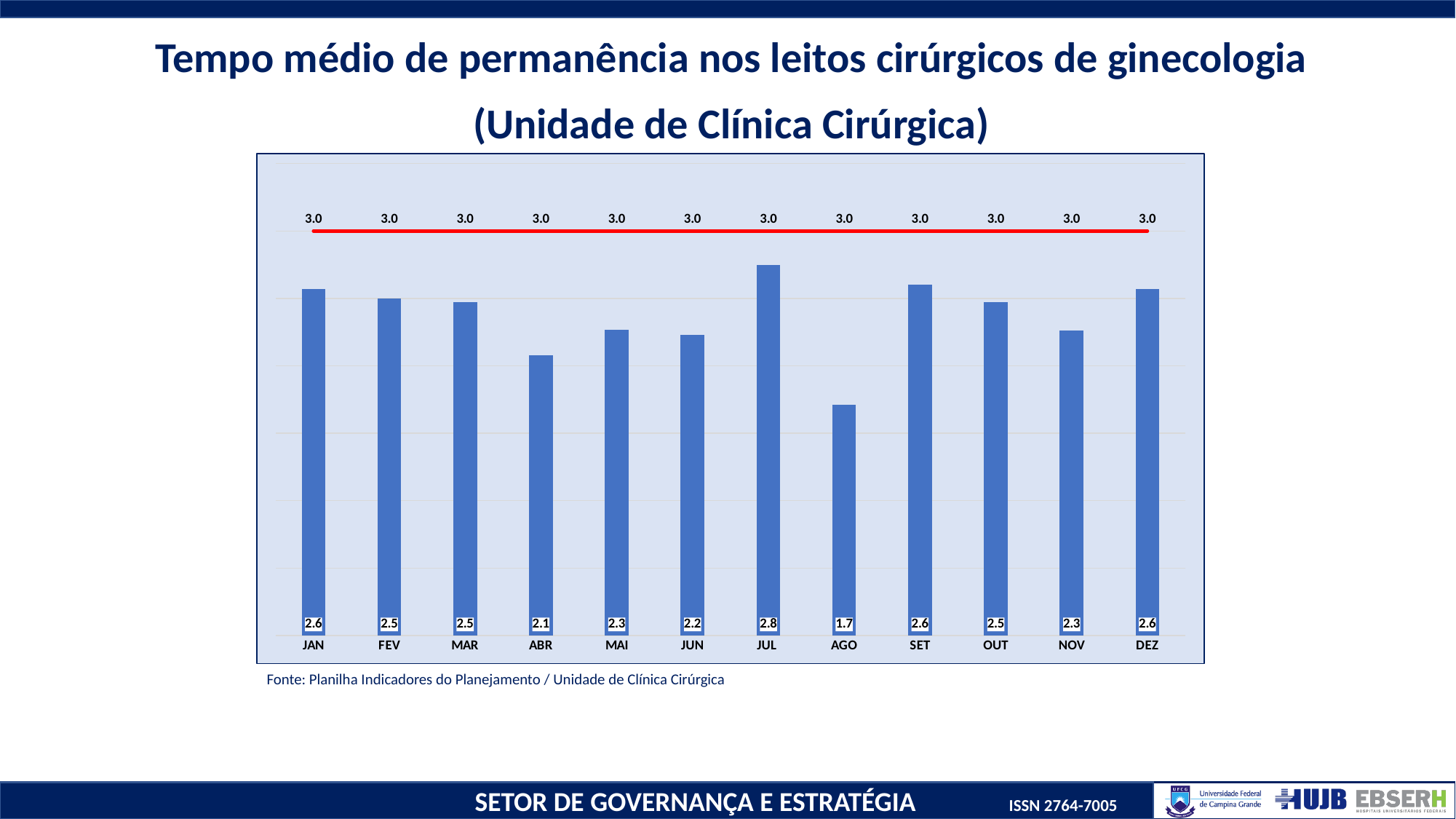
Which month has the highest bar value? JUL What is the value of the bar for ABR? 2.1 What value does the red line show for every month? 3.0 Which month has the lowest bar value? AGO Do the bar values rise or fall from JUL to AGO? Fall What is the value of the bar for AGO? 1.7 What is the difference between the bar values for JUL and AGO? 1.1 What is the difference between the red line value and the bar value for JAN? 0.4 What kind of chart is shown on the slide? Bar chart with a line Which is larger, the bar value for MAI or the bar value for ABR? MAI How many months are shown on the x axis? 12 What is the value of the bar for JUL? 2.8